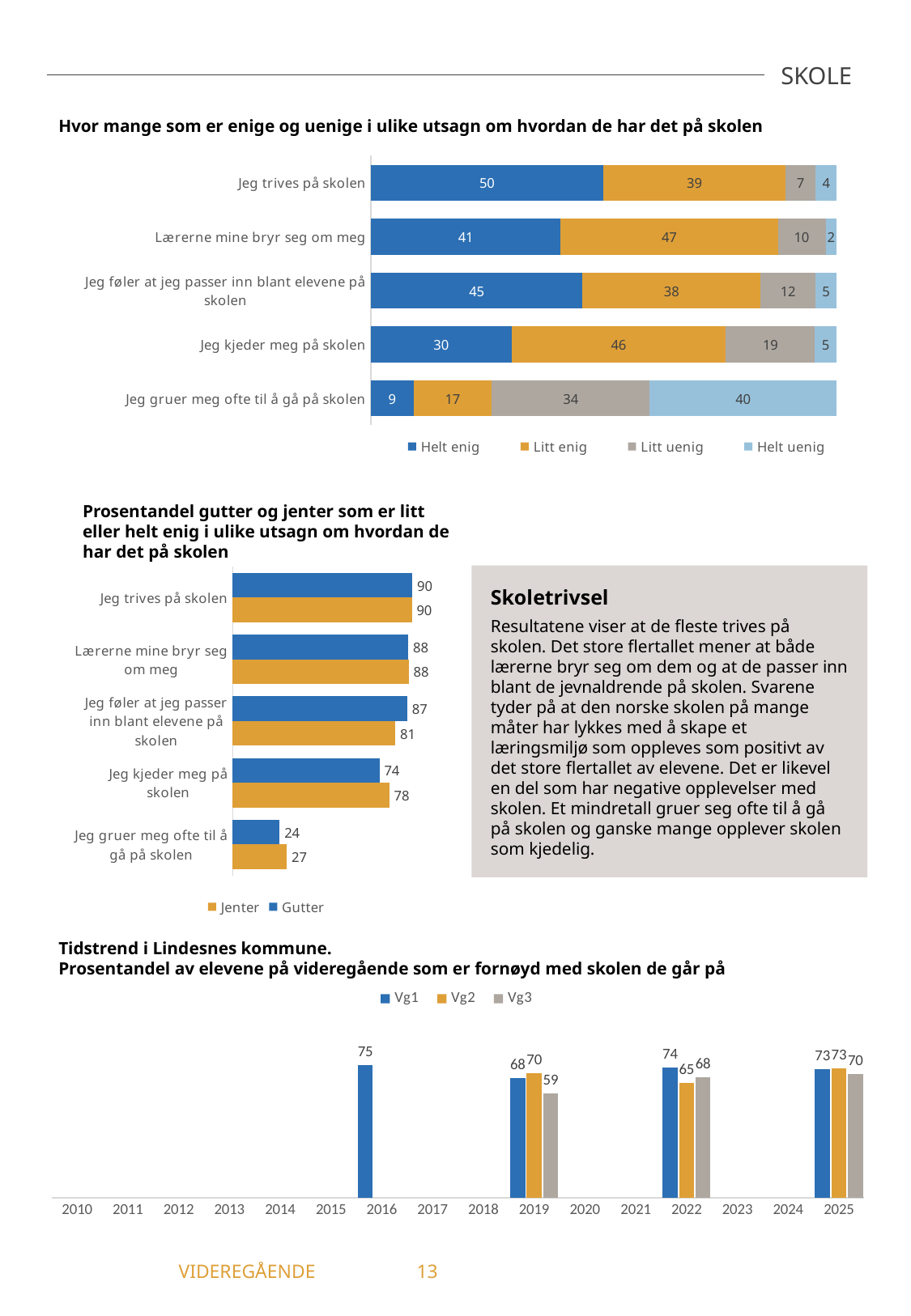
In the chart 'Prosentandel gutter og jenter som er litt eller helt enig i ulike utsagn om hvordan de har det på skolen', how many statements are shown? 5 In the chart 'Prosentandel gutter og jenter som er litt eller helt enig i ulike utsagn om hvordan de har det på skolen', which is larger for 'Jeg føler at jeg passer inn blant elevene på skolen': Gutter or Jenter? Gutter In the chart 'Hvor mange som er enige og uenige i ulike utsagn om hvordan de har det på skolen', how many series does the legend list? 4 In the chart 'Prosentandel gutter og jenter som er litt eller helt enig i ulike utsagn om hvordan de har det på skolen', which statement has the lowest Gutter value? Jeg gruer meg ofte til å gå på skolen In the chart 'Prosentandel gutter og jenter som er litt eller helt enig i ulike utsagn om hvordan de har det på skolen', what is the Jenter value for 'Jeg kjeder meg på skolen'? 78 In the chart 'Hvor mange som er enige og uenige i ulike utsagn om hvordan de har det på skolen', which statement has the highest 'Litt uenig' value? Jeg gruer meg ofte til å gå på skolen What kind of chart is 'Tidstrend i Lindesnes kommune'? Bar chart In the chart 'Hvor mange som er enige og uenige i ulike utsagn om hvordan de har det på skolen', what is the difference between the 'Litt enig' values for 'Lærerne mine bryr seg om meg' and 'Jeg trives på skolen'? 8 In the chart 'Tidstrend i Lindesnes kommune', what is the Vg3 value for 2019? 59 In the chart 'Hvor mange som er enige og uenige i ulike utsagn om hvordan de har det på skolen', what is the 'Helt enig' value for 'Jeg trives på skolen'? 50 In the chart 'Tidstrend i Lindesnes kommune', what is the difference between the Vg1 values for 2016 and 2019? 7 In the chart 'Hvor mange som er enige og uenige i ulike utsagn om hvordan de har det på skolen', what is the 'Helt uenig' value for 'Jeg gruer meg ofte til å gå på skolen'? 40